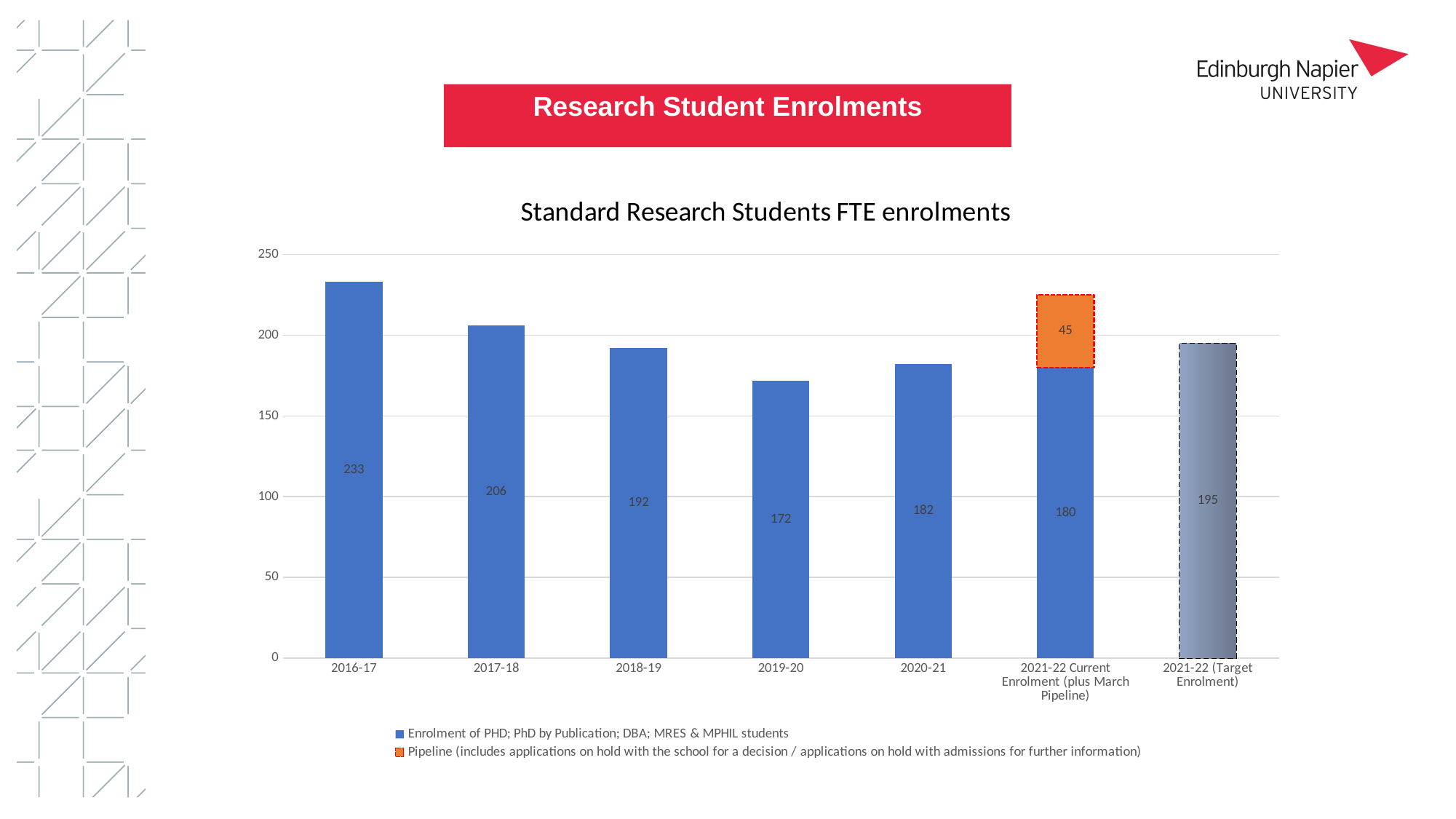
Which year has the highest enrolment value? 2016-17 Which year has the lowest enrolment value among 2016-17 to 2020-21? 2019-20 What is the enrolment value for 2016-17? 233 What is the Pipeline value for 2021-22 Current Enrolment (plus March Pipeline)? 45 What is the total of the 2021-22 Current Enrolment (plus March Pipeline) bar, including the pipeline? 225 What is the difference between the enrolment values for 2016-17 and 2017-18? 27 What type of chart is shown on the slide? Bar chart What is the value shown for 2021-22 (Target Enrolment)? 195 What is the enrolment value for 2019-20? 172 How many categories are shown on the x axis? 7 Which is larger, the enrolment value for 2018-19 or for 2020-21? 2018-19 How many series does the legend list? 2